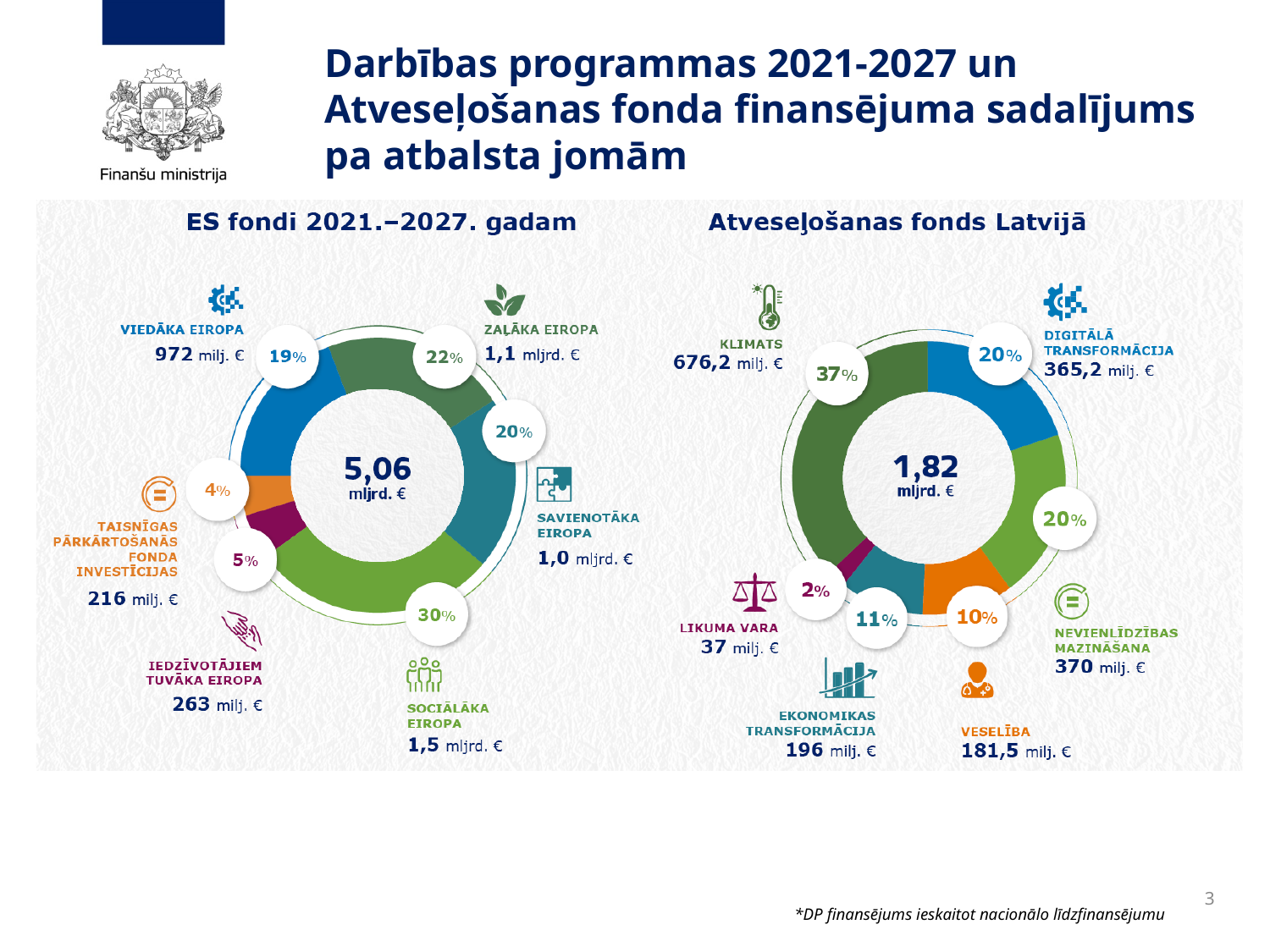
In the 'ES fondi 2021.–2027. gadam' chart, which category has the largest share? Sociālāka Eiropa In the 'ES fondi 2021.–2027. gadam' chart, what is the amount for Viedāka Eiropa? 972 milj. € In the 'Atveseļošanas fonds Latvijā' chart, what share does Klimats have? 37% In the 'ES fondi 2021.–2027. gadam' chart, what share does Sociālāka Eiropa have? 30% How many categories are shown in the 'ES fondi 2021.–2027. gadam' chart? 6 What type of chart is used on this slide? Donut (pie) chart In the 'Atveseļošanas fonds Latvijā' chart, what is the difference in percentage points between Klimats and Ekonomikas transformācija? 26 percentage points In the 'Atveseļošanas fonds Latvijā' chart, which is larger: the share for Ekonomikas transformācija or the share for Veselība? Ekonomikas transformācija In the 'ES fondi 2021.–2027. gadam' chart, what total amount is shown in the centre of the donut? 5,06 mljrd. € In the 'Atveseļošanas fonds Latvijā' chart, what is the amount for Veselība? 181,5 milj. € In the 'Atveseļošanas fonds Latvijā' chart, which category has the smallest share? Likuma vara In the 'ES fondi 2021.–2027. gadam' chart, which category has the smallest share? Taisnīgas pārkārtošanās fonda investīcijas